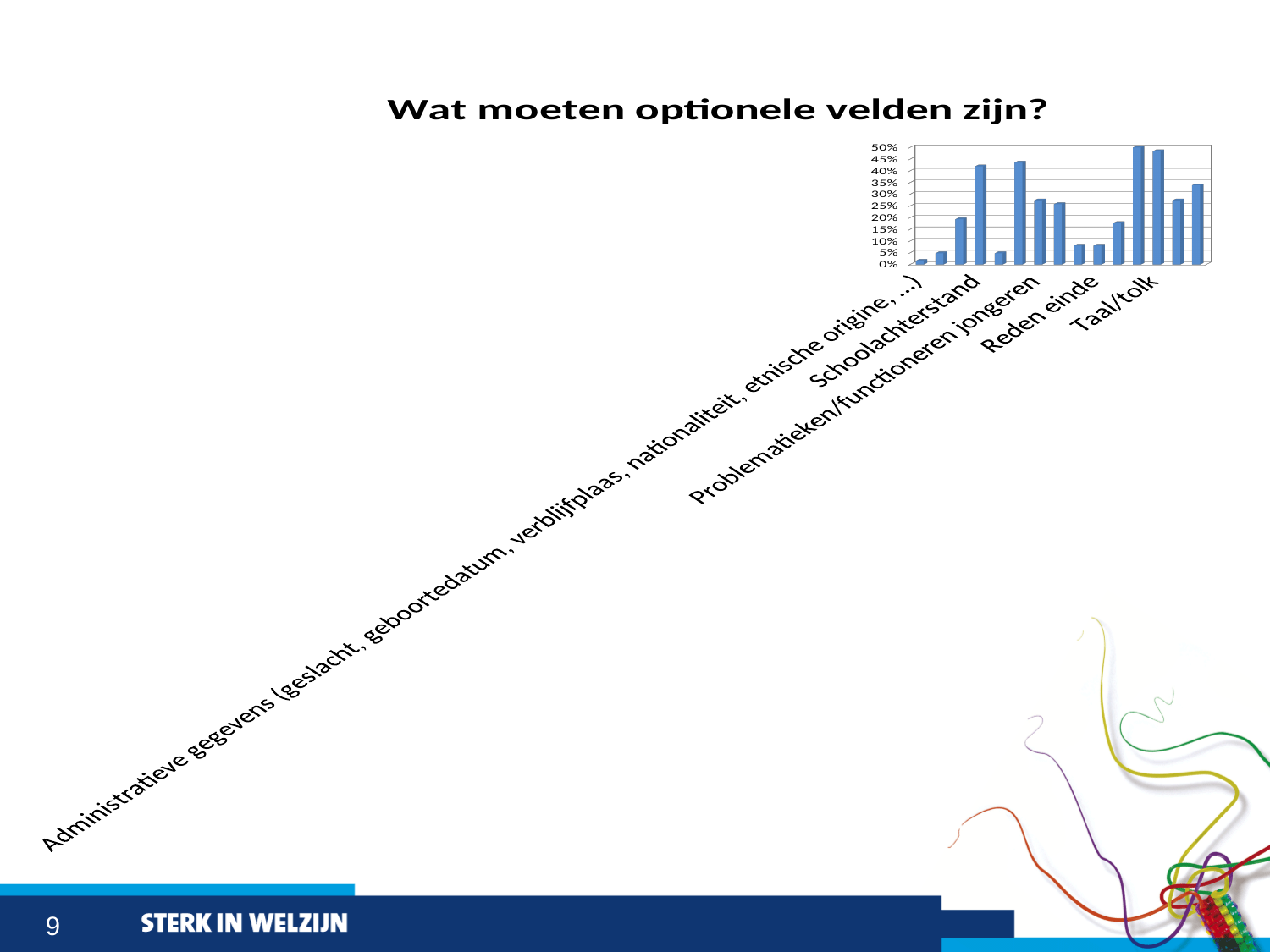
Which has the larger value, Schoolachterstand or Administratieve gegevens (geslacht, geboortedatum, verblijfplaas, nationaliteit, etnische origine, ...)? Schoolachterstand What is the title of the chart? Wat moeten optionele velden zijn? Is the value for Schoolachterstand greater or less than 35%? greater What is the highest value shown on the vertical axis of the chart? 50% How many bars are plotted in the chart? 15 Is the value for Administratieve gegevens (geslacht, geboortedatum, verblijfplaas, nationaliteit, etnische origine, ...) greater or less than 5%? less Which has the larger value, Taal/tolk or Problematieken/functioneren jongeren? Taal/tolk Is the value for Reden einde greater or less than 15%? less What kind of chart is shown on the slide? bar chart Which has the larger value, Schoolachterstand or Reden einde? Schoolachterstand